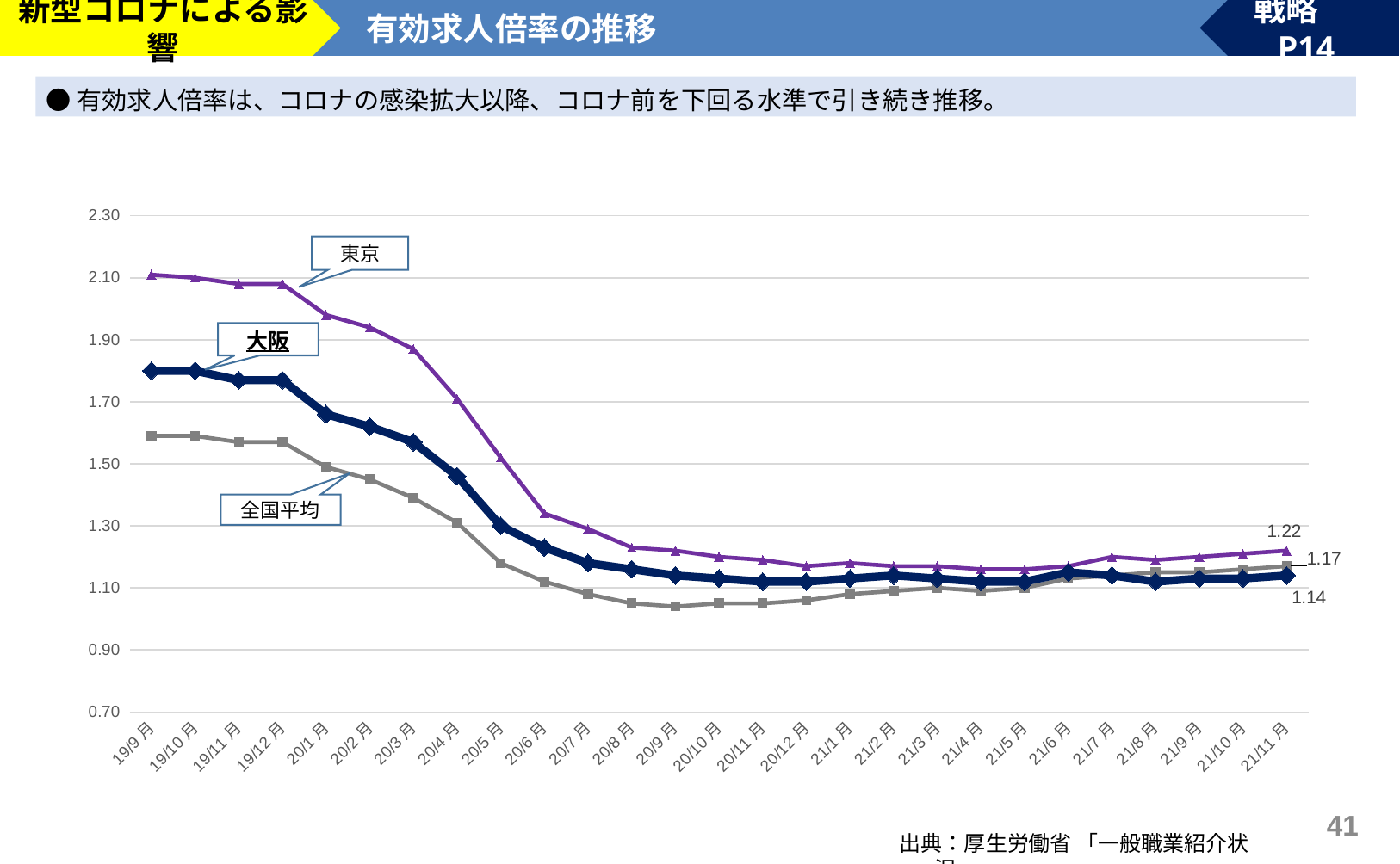
How many series are plotted on the chart? 3 What is the value for 東京 at 21/11月? 1.22 Is the value for 大阪 at 19/9月 greater or less than 1.70? greater What is the value for 全国平均 at 21/11月? 1.17 Does the 東京 line rise or fall from 19/9月 to 20/9月? fall What kind of chart is shown on the slide? line chart At 21/11月, how much higher is 東京 than 大阪? 0.08 Which series has the highest value at 19/9月? 東京 What is the value for 大阪 at 21/11月? 1.14 Is the value for 全国平均 at 20/9月 greater or less than 1.10? less Which series has the lowest value at 19/9月? 全国平均 At 21/11月, which is larger, 大阪 or 全国平均? 全国平均